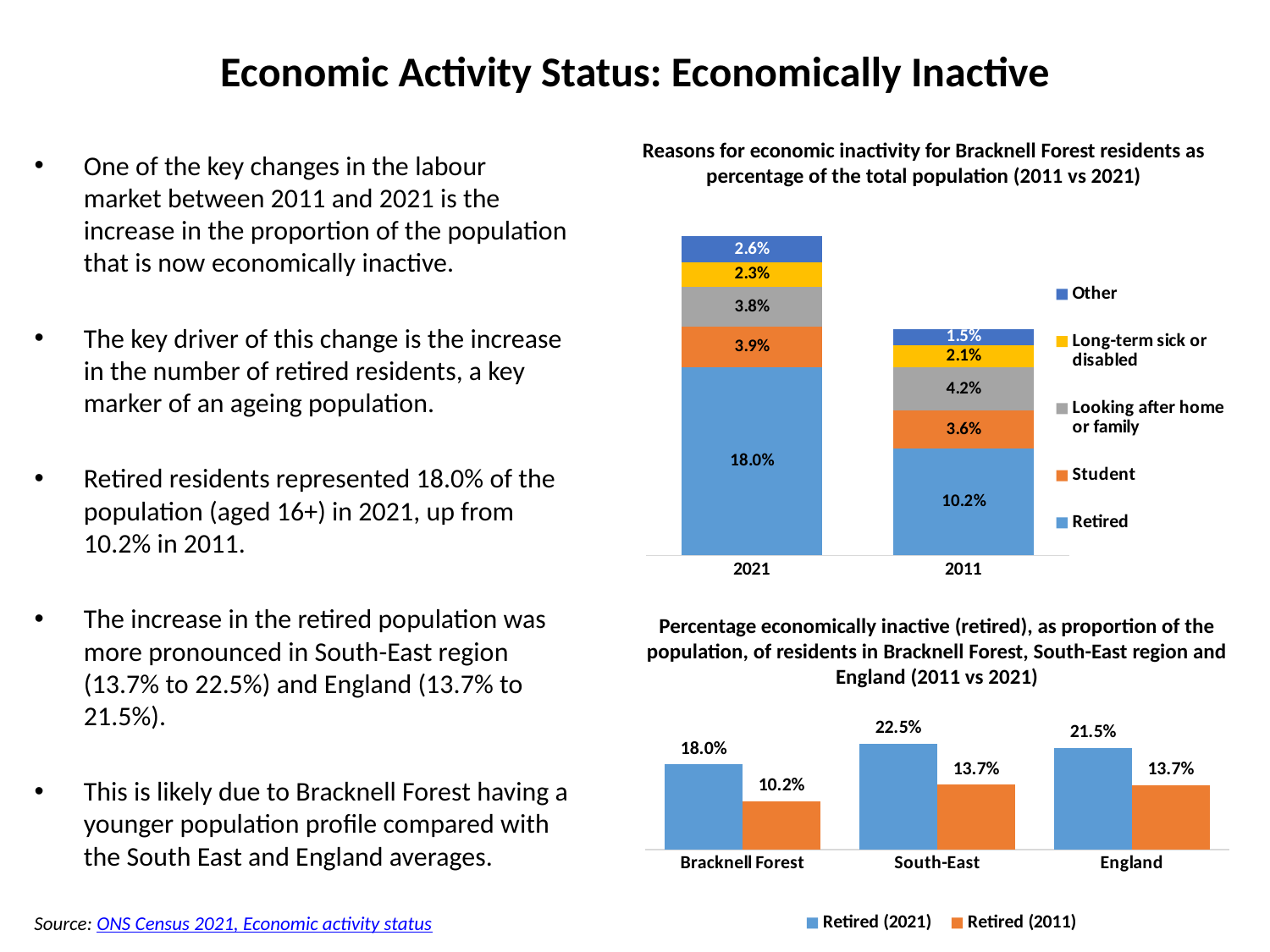
In the bottom chart (Percentage economically inactive (retired)), what is the value for Retired (2021) in South-East? 22.5% In the top chart (Reasons for economic inactivity for Bracknell Forest residents), what is the difference between the Other values for 2021 and 2011? 1.1% In the bottom chart (Percentage economically inactive (retired)), which region has the highest Retired (2021) value? South-East In the top chart (Reasons for economic inactivity for Bracknell Forest residents), what is the total of the stacked bar for 2021? 30.6% What kind of chart is the bottom chart (Percentage economically inactive (retired))? Bar chart In the top chart (Reasons for economic inactivity for Bracknell Forest residents), how many series does the legend list? 5 In the bottom chart (Percentage economically inactive (retired)), which region has the lowest Retired (2011) value? Bracknell Forest In the top chart (Reasons for economic inactivity for Bracknell Forest residents), what is the value for Looking after home or family in 2011? 4.2% In the bottom chart (Percentage economically inactive (retired)), what is the difference between Retired (2021) and Retired (2011) for England? 7.8% In the top chart (Reasons for economic inactivity for Bracknell Forest residents), which is larger: Student in 2021 or Student in 2011? Student in 2021 In the top chart (Reasons for economic inactivity for Bracknell Forest residents), what is the total of the stacked bar for 2011? 21.6% In the top chart (Reasons for economic inactivity for Bracknell Forest residents), what is the value for Retired in 2021? 18.0%